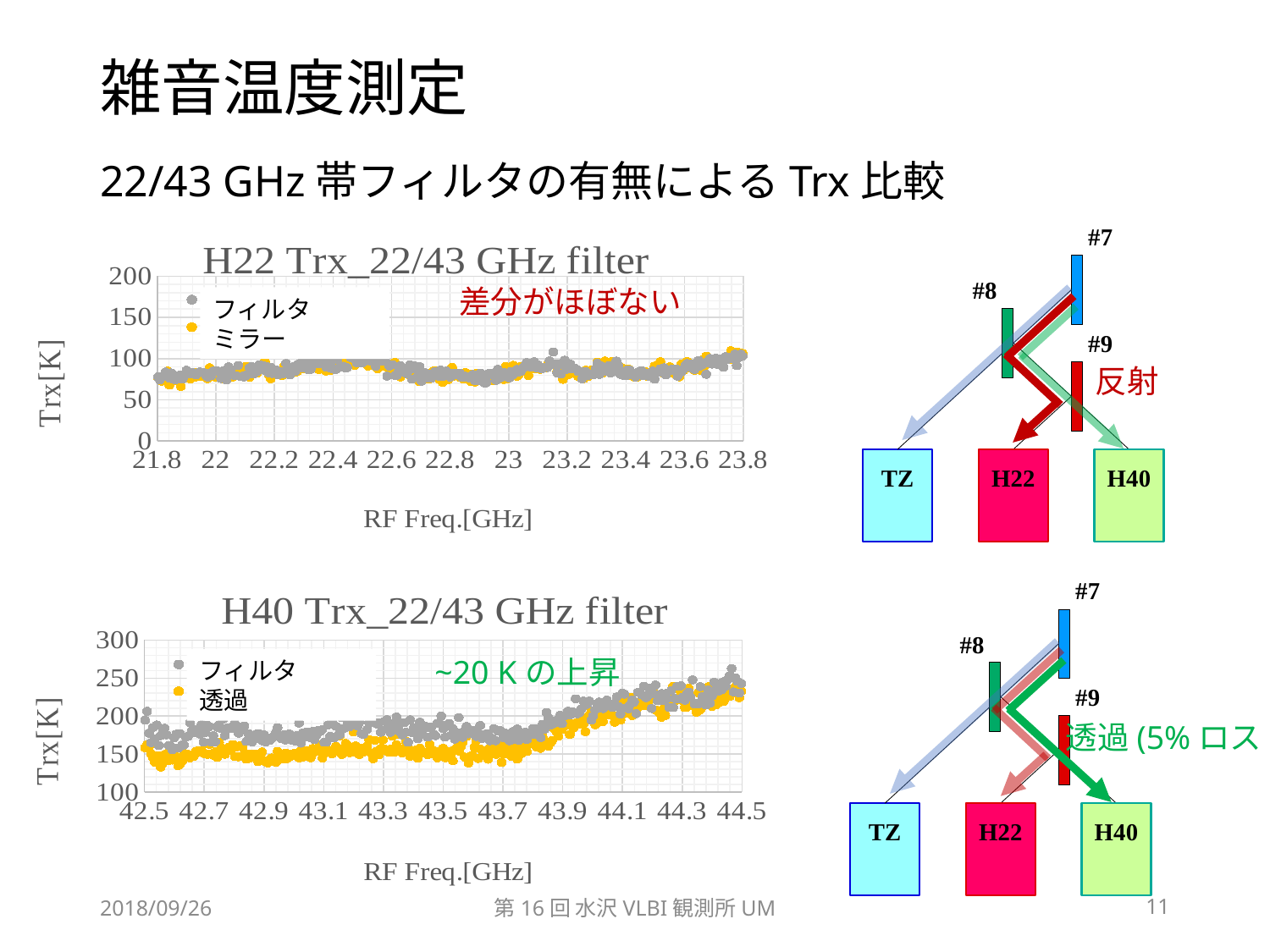
What kind of chart is the top chart titled "H22 Trx_22/43 GHz filter"? scatter chart What are the two legend entries of the top chart "H22 Trx_22/43 GHz filter"? フィルタ and ミラー What is the x-axis label of the top chart "H22 Trx_22/43 GHz filter"? RF Freq.[GHz] In the bottom chart "H40 Trx_22/43 GHz filter", which series has the higher Trx values across the band, フィルタ or 透過? フィルタ What kind of chart is the bottom chart titled "H40 Trx_22/43 GHz filter"? scatter chart In the top chart "H22 Trx_22/43 GHz filter", are the Trx values around 23.6 GHz greater or less than 50 K? greater In the bottom chart "H40 Trx_22/43 GHz filter", do the Trx values rise or fall from 43.7 GHz to 44.5 GHz? rise In the top chart "H22 Trx_22/43 GHz filter", are the Trx values around 22.6 GHz greater or less than 150 K? less In the bottom chart "H40 Trx_22/43 GHz filter", is the 透過 series value around 43.0 GHz greater or less than 200 K? less How many series does the legend of the top chart "H22 Trx_22/43 GHz filter" list? 2 How many series does the legend of the bottom chart "H40 Trx_22/43 GHz filter" list? 2